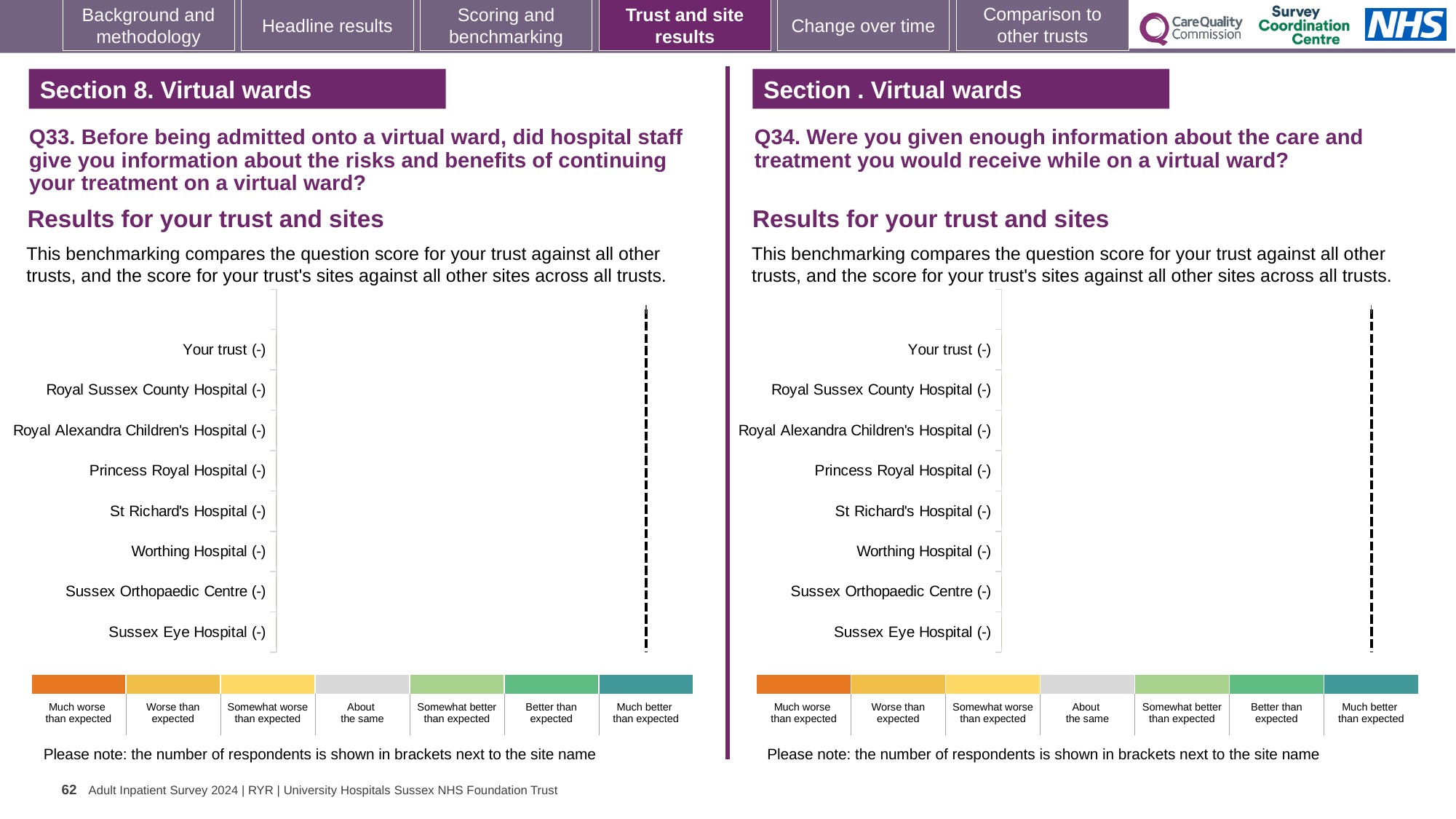
In the Q34 chart on the right, how many sites or categories are listed on the vertical axis? 8 In the Q33 chart on the left, how many sites or categories are listed on the vertical axis? 8 In the Q33 chart on the left, what is the first category listed at the top of the vertical axis? Your trust (-) In the Q34 chart on the right, what number of respondents is shown in brackets next to Princess Royal Hospital? - In the Q34 chart on the right, how many categories does the colour legend below the chart list? 7 In the Q33 chart on the left, what number of respondents is shown in brackets next to Worthing Hospital? - In the Q33 chart on the left, how many categories does the colour legend below the chart list? 7 In the Q34 chart on the right, what is the last category listed at the bottom of the vertical axis? Sussex Eye Hospital (-)